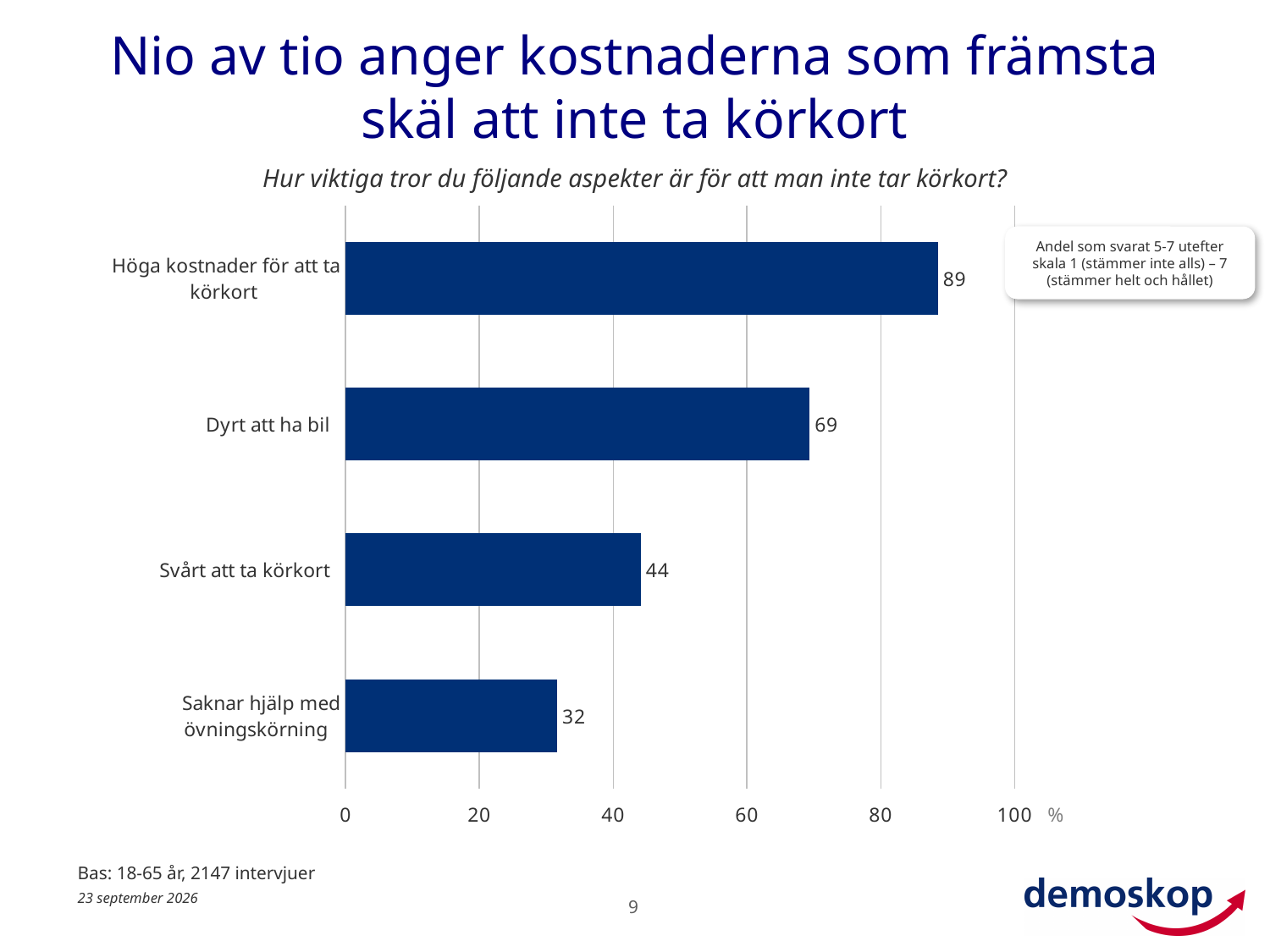
What is the value for "Dyrt att ha bil"? 69 What is the difference between the values for "Svårt att ta körkort" and "Saknar hjälp med övningskörning"? 12 What is the value for "Höga kostnader för att ta körkort"? 89 How many categories are shown in the chart? 4 Which category has the lowest value? Saknar hjälp med övningskörning What is the value for "Saknar hjälp med övningskörning"? 32 What is the value for "Svårt att ta körkort"? 44 Which category has the highest value? Höga kostnader för att ta körkort What is the difference between the values for "Höga kostnader för att ta körkort" and "Dyrt att ha bil"? 20 Is the value for "Svårt att ta körkort" greater or less than 40? greater Which is larger, the value for "Dyrt att ha bil" or the value for "Svårt att ta körkort"? Dyrt att ha bil What kind of chart is shown on the slide? bar chart